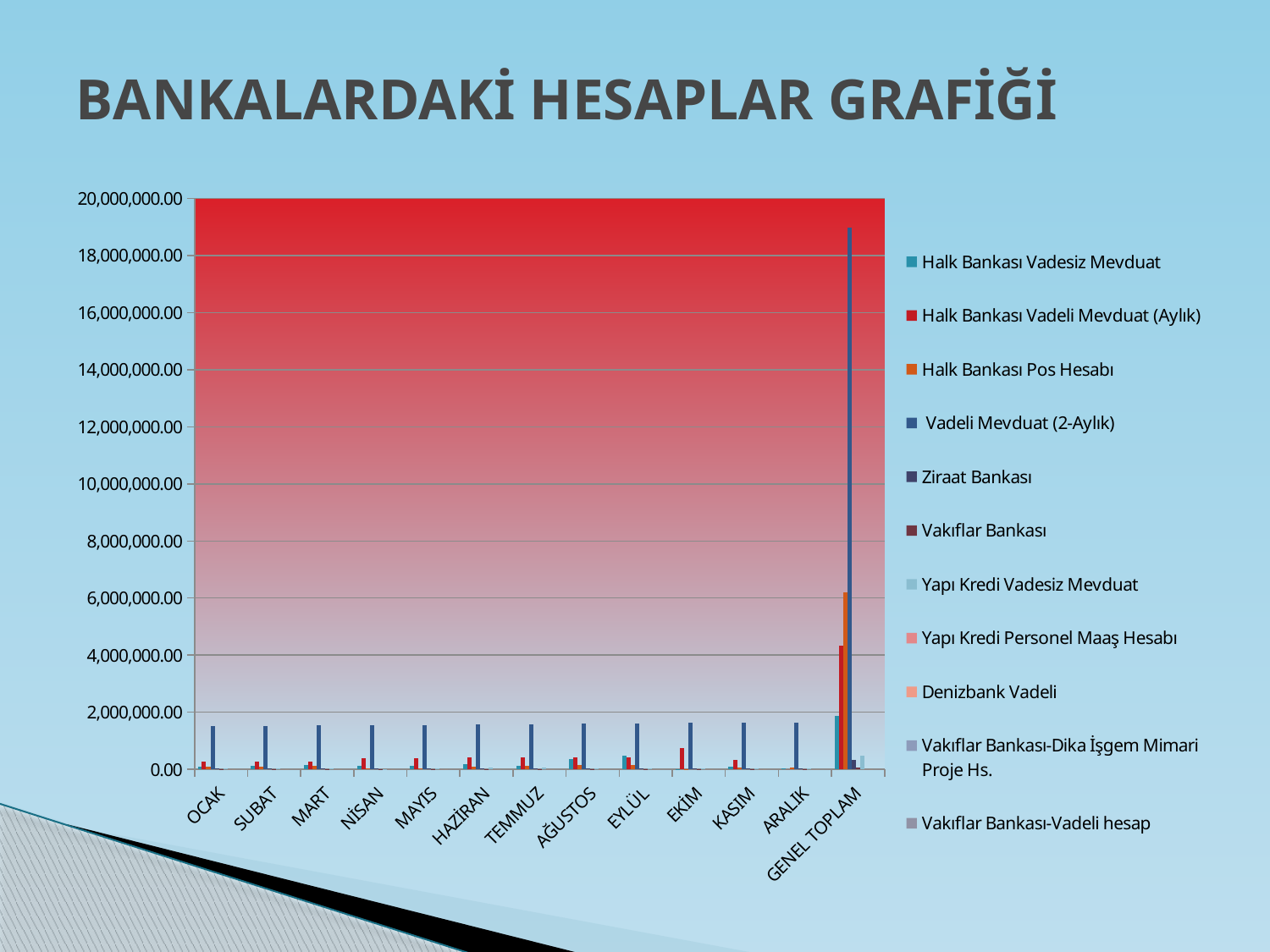
Is the value for Ziraat Bankası in OCAK greater or less than 2,000,000.00? less How many categories are shown along the x axis of the chart? 13 Which series has the tallest bar in the GENEL TOPLAM category? Vadeli Mevduat (2-Aylık) How many series does the chart's legend list? 11 Is the value for Halk Bankası Vadeli Mevduat (Aylık) in GENEL TOPLAM greater or less than 2,000,000.00? greater What is the title of the slide containing the chart? BANKALARDAKİ HESAPLAR GRAFİĞİ Is the value for Halk Bankası Pos Hesabı in GENEL TOPLAM greater or less than 4,000,000.00? greater What is the first entry listed in the chart's legend? Halk Bankası Vadesiz Mevduat What kind of chart is shown on the slide? bar chart In the GENEL TOPLAM category, which is larger: Ziraat Bankası or Halk Bankası Pos Hesabı? Halk Bankası Pos Hesabı Which category contains the tallest bar in the chart? GENEL TOPLAM